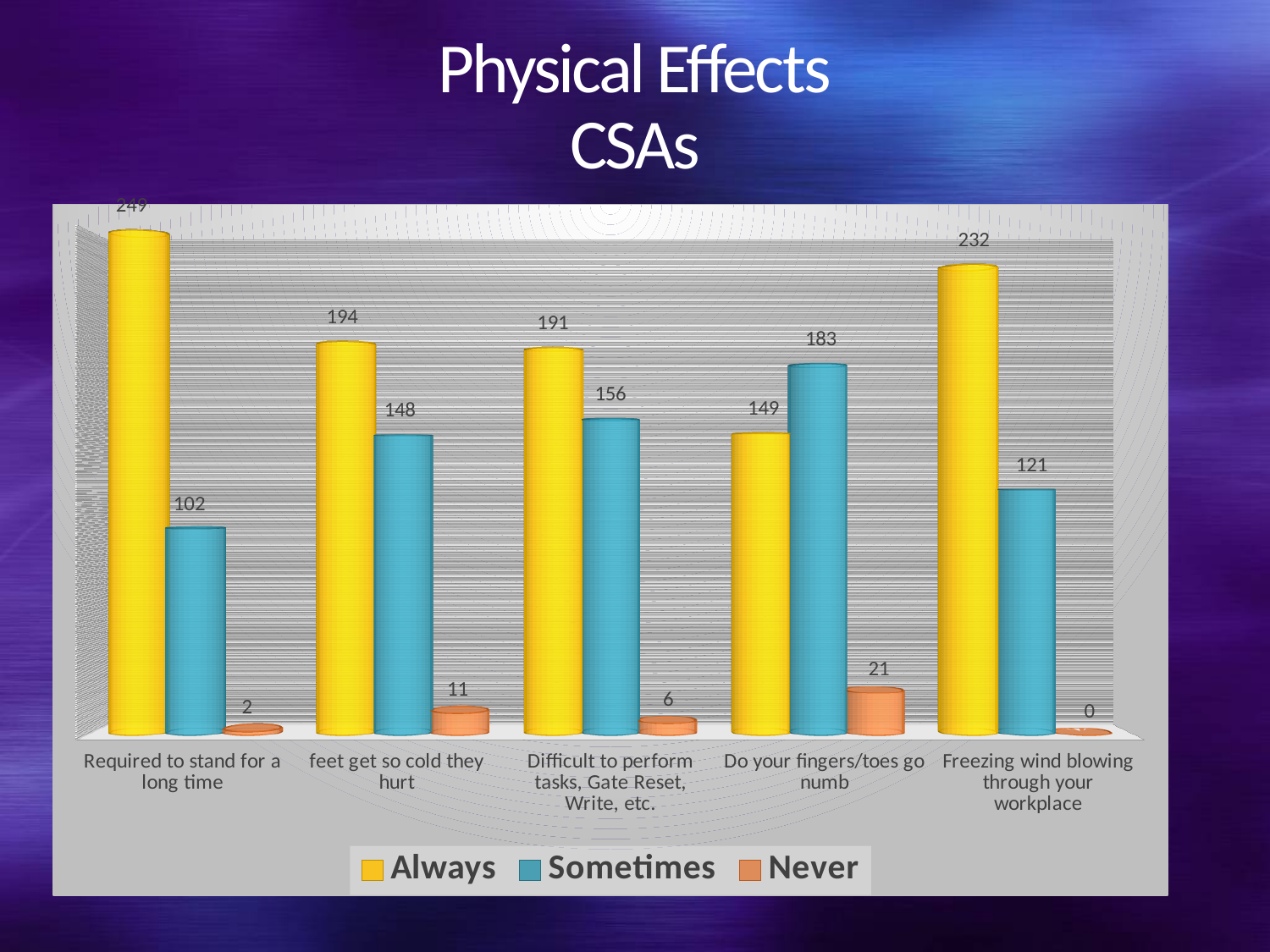
What is the 'Always' value for 'Required to stand for a long time'? 249 Which category has the highest 'Always' value? Required to stand for a long time How many series does the legend list? 3 Which series is shown in yellow? Always What kind of chart is shown on the slide? Bar chart What is the 'Sometimes' value for 'Freezing wind blowing through your workplace'? 121 Which is larger for 'Do your fingers/toes go numb': the 'Always' value or the 'Sometimes' value? Sometimes What is the 'Never' value for 'feet get so cold they hurt'? 11 Which category has the lowest 'Never' value? Freezing wind blowing through your workplace What is the 'Sometimes' value for 'Do your fingers/toes go numb'? 183 What is the difference between the 'Always' and 'Sometimes' values for 'Difficult to perform tasks, Gate Reset, Write, etc.'? 35 How many categories are shown on the x axis? 5